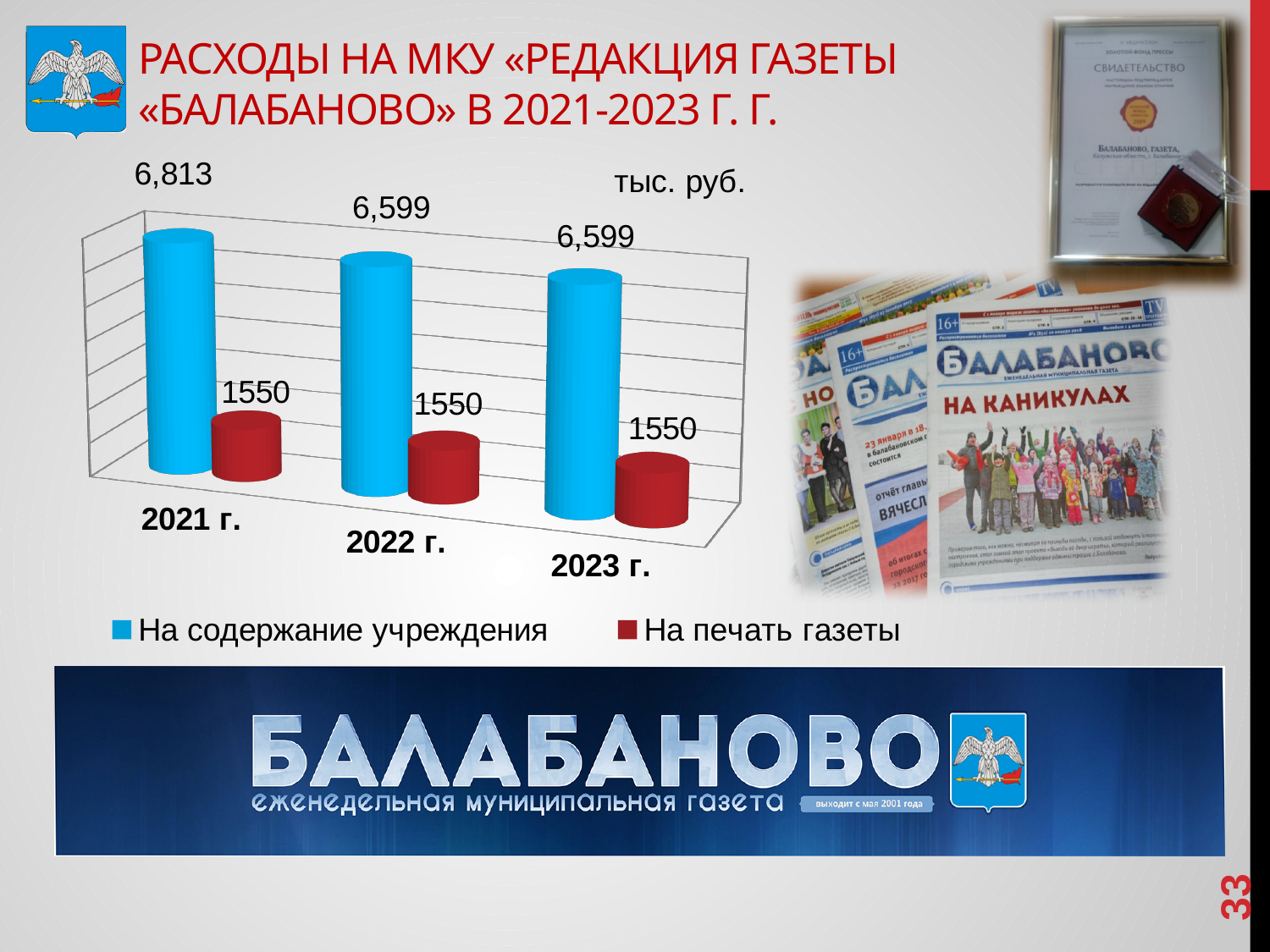
How many series does the legend list? 2 What is the difference between the «На содержание учреждения» values for 2021 г. and 2022 г.? 214 What unit is indicated for the values on the chart? тыс. руб. Does the value for «На печать газеты» rise, fall or stay the same from 2021 г. to 2023 г.? Stays the same What is the value for «На содержание учреждения» in 2021 г.? 6,813 What kind of chart is shown on the slide? Bar chart How many years (categories) are shown on the chart? 3 In which year is the value for «На содержание учреждения» the highest? 2021 г. What is the value for «На содержание учреждения» in 2022 г.? 6,599 What is the difference between «На содержание учреждения» and «На печать газеты» in 2023 г.? 5,049 What is the value for «На печать газеты» in 2023 г.? 1550 Which is larger in 2022 г.: «На содержание учреждения» or «На печать газеты»? На содержание учреждения